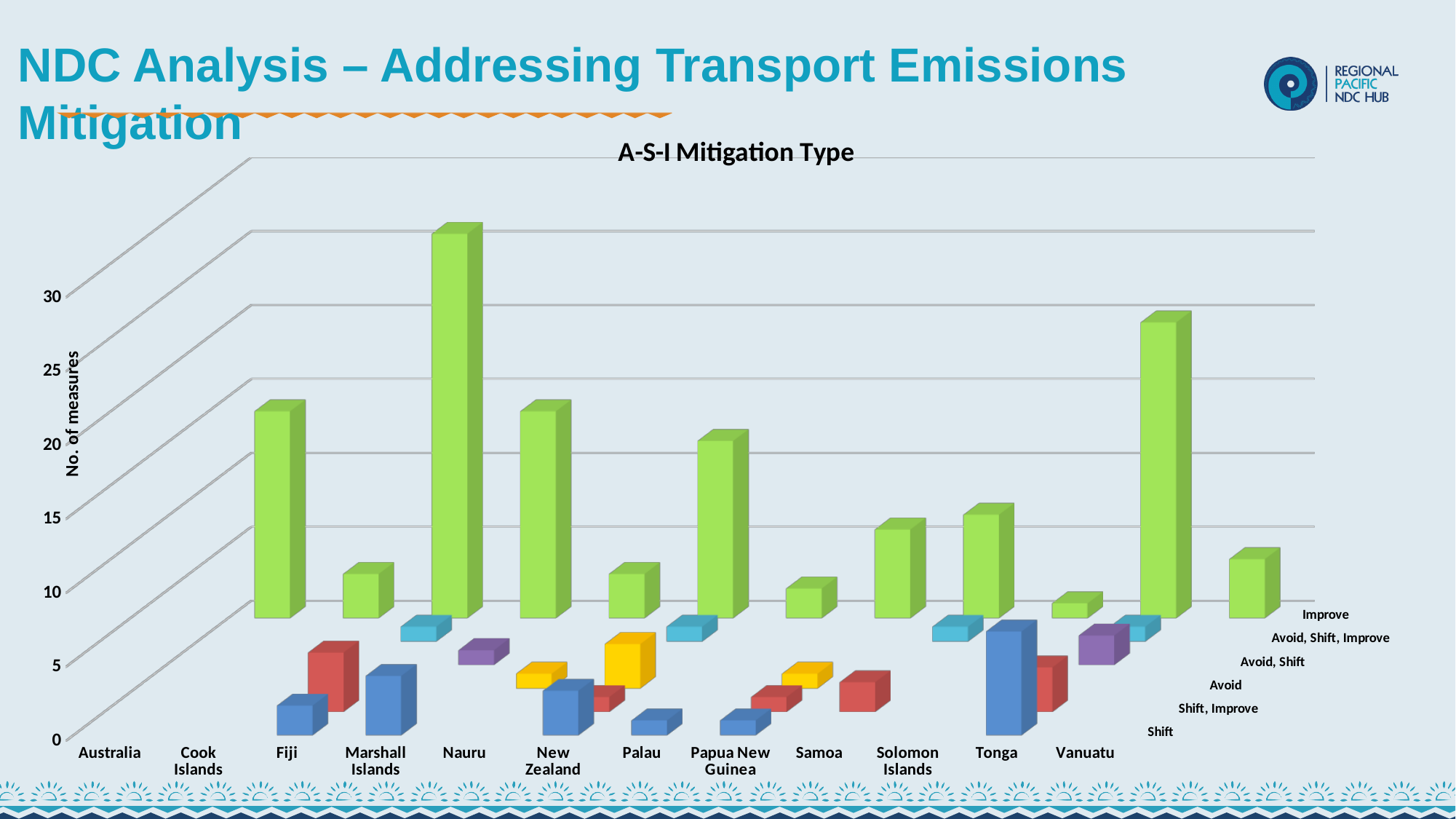
Which has more Improve measures, Nauru or Fiji? Fiji Is the number of Improve measures for Nauru greater or less than 20? less What kind of chart is shown on the slide? bar chart What is the label on the vertical axis of the chart? No. of measures Which country has the highest number of Shift measures? Tonga What is the title of the chart? A-S-I Mitigation Type Which has more Shift measures, Tonga or Fiji? Tonga How many countries are listed along the horizontal axis of the chart? 12 How many mitigation-type series does the chart show? 6 Is the number of Improve measures for Fiji greater or less than 15? greater Which country has the highest number of Improve measures? Fiji